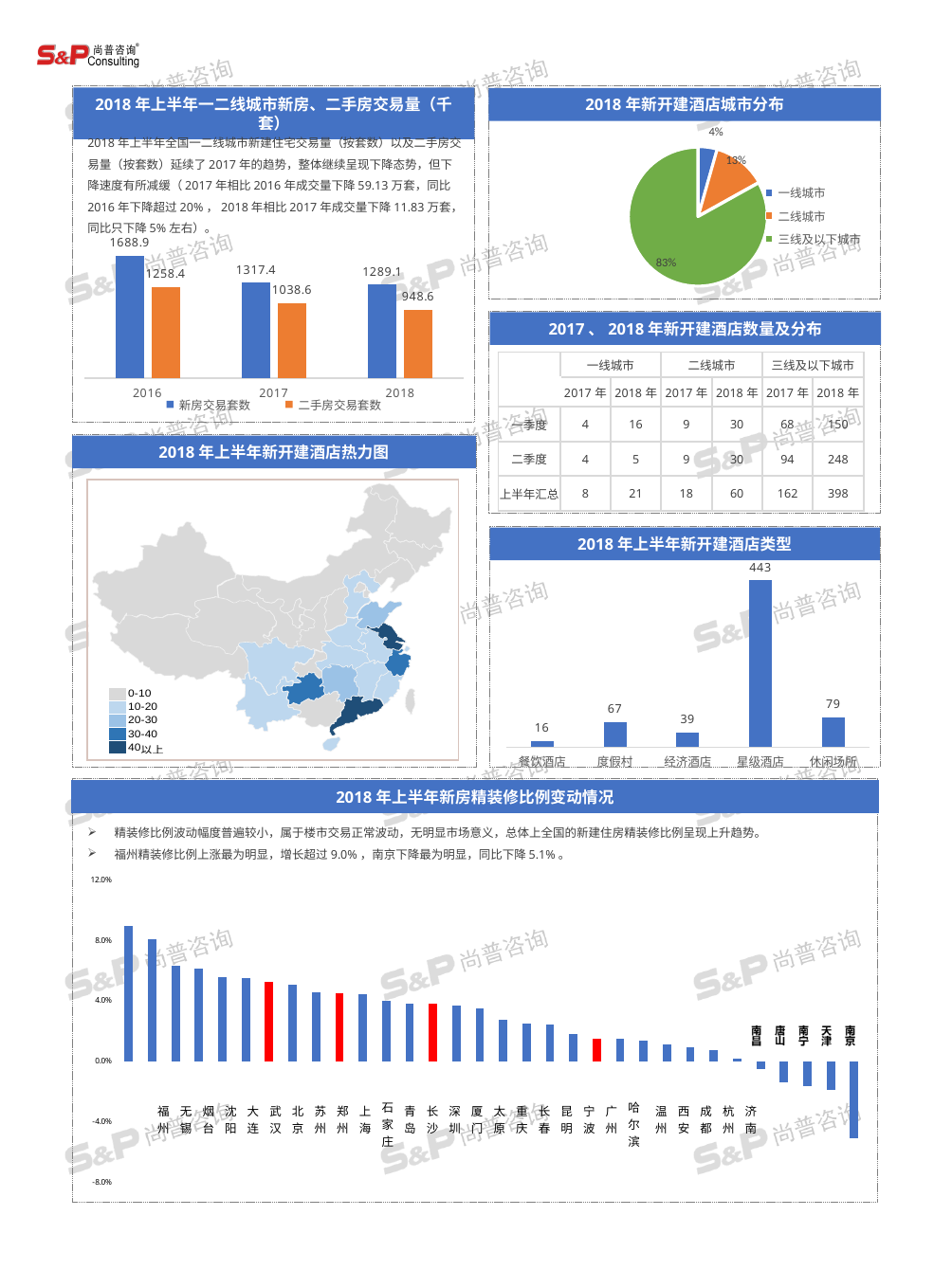
In the chart titled 2018年上半年一二线城市新房、二手房交易量（千套）, what is the difference between 新房交易套数 and 二手房交易套数 in 2017? 278.8 In the chart titled 2018年上半年一二线城市新房、二手房交易量（千套）, what is the value of 新房交易套数 for 2016? 1688.9 In the pie chart titled 2018年新开建酒店城市分布, what share do 三线及以下城市 hold? 83% In the chart titled 2018年上半年一二线城市新房、二手房交易量（千套）, does the 新房交易套数 series rise or fall from 2016 to 2018? fall What kind of chart is the one titled 2018年新开建酒店城市分布? pie chart In the chart titled 2018年上半年一二线城市新房、二手房交易量（千套）, what is the value of 二手房交易套数 for 2018? 948.6 In the chart titled 2018年上半年新开建酒店类型, what is the value for 度假村? 67 How many series does the legend list in the chart titled 2018年上半年一二线城市新房、二手房交易量（千套）? 2 In the chart titled 2018年上半年新房精装修比例变动情况, is the value for 福州 greater or less than 8.0%? greater In the chart titled 2018年上半年新开建酒店类型, which category has the highest value? 星级酒店 In the chart titled 2018年上半年新开建酒店类型, how many categories are shown on the x axis? 5 In the pie chart titled 2018年新开建酒店城市分布, which category has the smallest slice? 一线城市